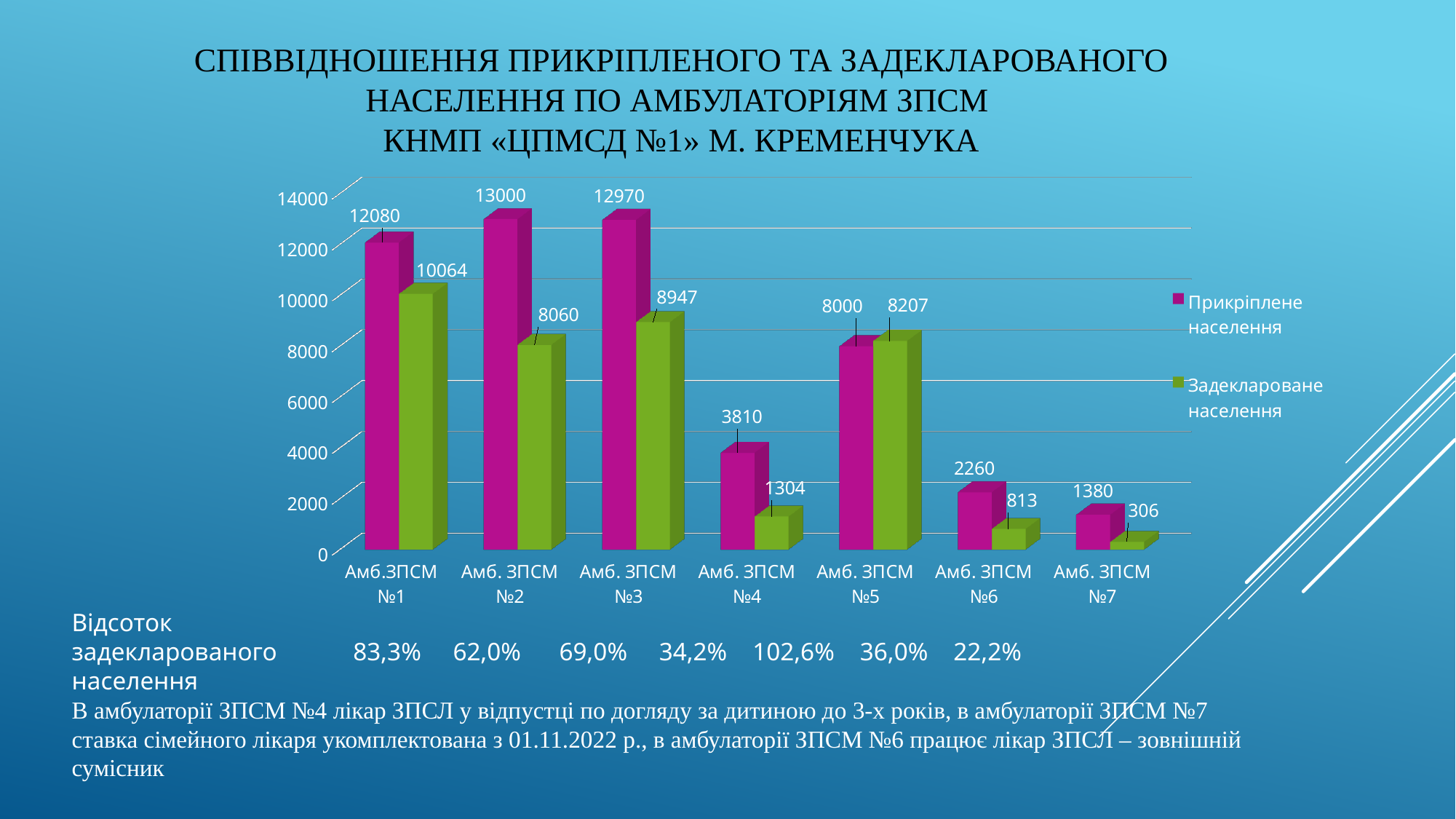
How many series does the legend list? 2 What colour represents Задеклароване населення in the chart? green What kind of chart is shown on the slide? bar chart Which is larger for Амб. ЗПСМ №5: Прикріплене населення or Задеклароване населення? Задеклароване населення Which category has the lowest value of Задеклароване населення? Амб. ЗПСМ №7 What is the value of Прикріплене населення for Амб. ЗПСМ №2? 13000 What is the value of Задеклароване населення for Амб. ЗПСМ №7? 306 Is the value of Прикріплене населення for Амб. ЗПСМ №6 greater or less than 4000? less Which category has the highest value of Прикріплене населення? Амб. ЗПСМ №2 What is the difference between Прикріплене населення and Задеклароване населення for Амб. ЗПСМ №4? 2506 How many categories (амбулаторії) are shown on the x axis? 7 What is the value of Задеклароване населення for Амб. ЗПСМ №3? 8947